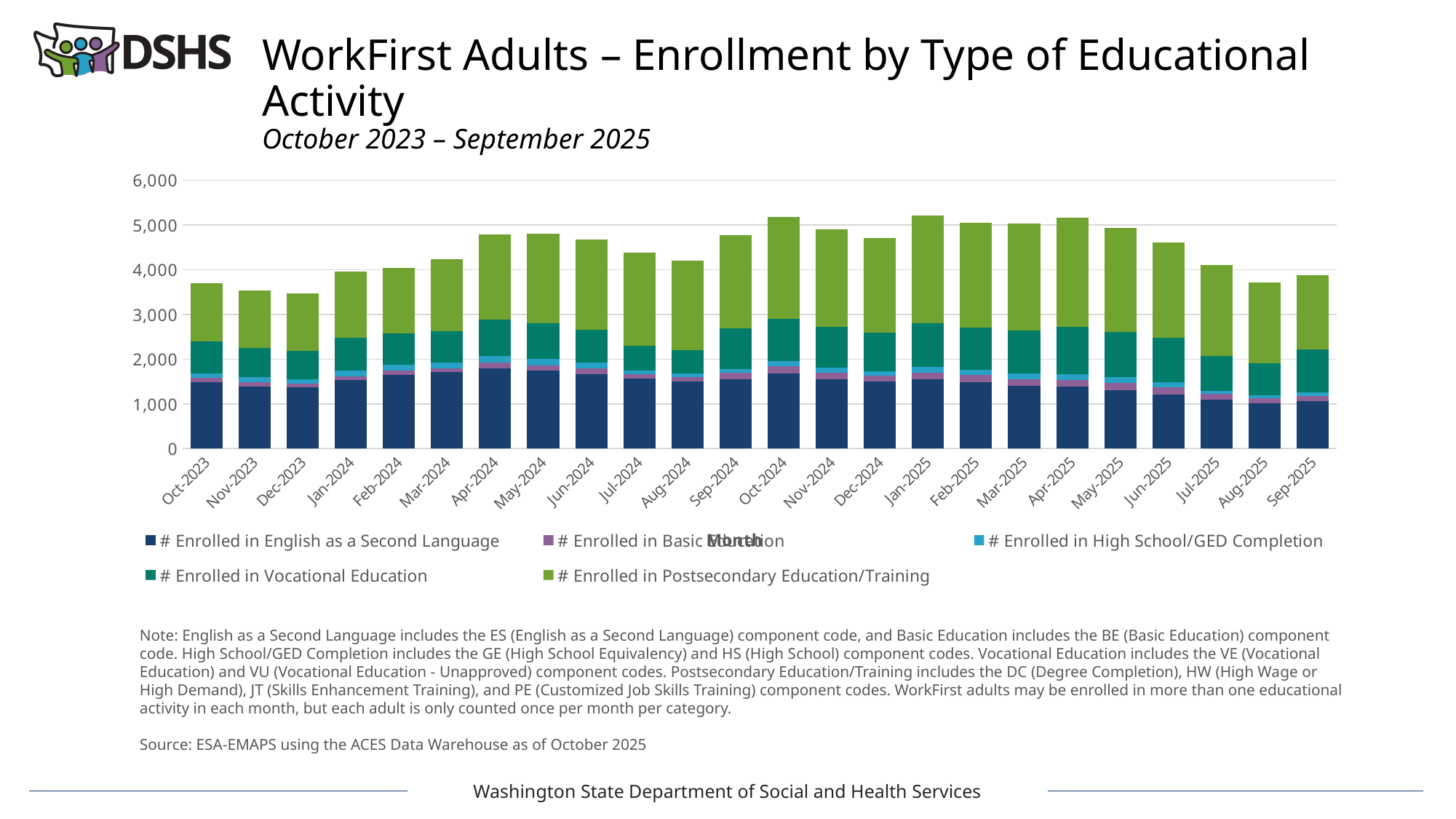
How many months (bars) are plotted on the chart? 24 What kind of chart is shown on the slide? Stacked bar chart Is the total enrollment bar for Oct-2023 greater or less than 4,000? less Which month has the taller total bar, Oct-2023 or Apr-2024? Apr-2024 Is the total enrollment bar for Jan-2025 greater or less than 5,000? greater Do the total enrollment bars rise or fall from Jun-2025 to Aug-2025? fall Which series is shown in light green at the top of each stacked bar? # Enrolled in Postsecondary Education/Training How many series does the legend list? 5 Which month has the taller total bar, Jan-2025 or Aug-2025? Jan-2025 What date range does the chart subtitle give? October 2023 – September 2025 Is the number enrolled in English as a Second Language in Oct-2023 greater or less than 2,000? less